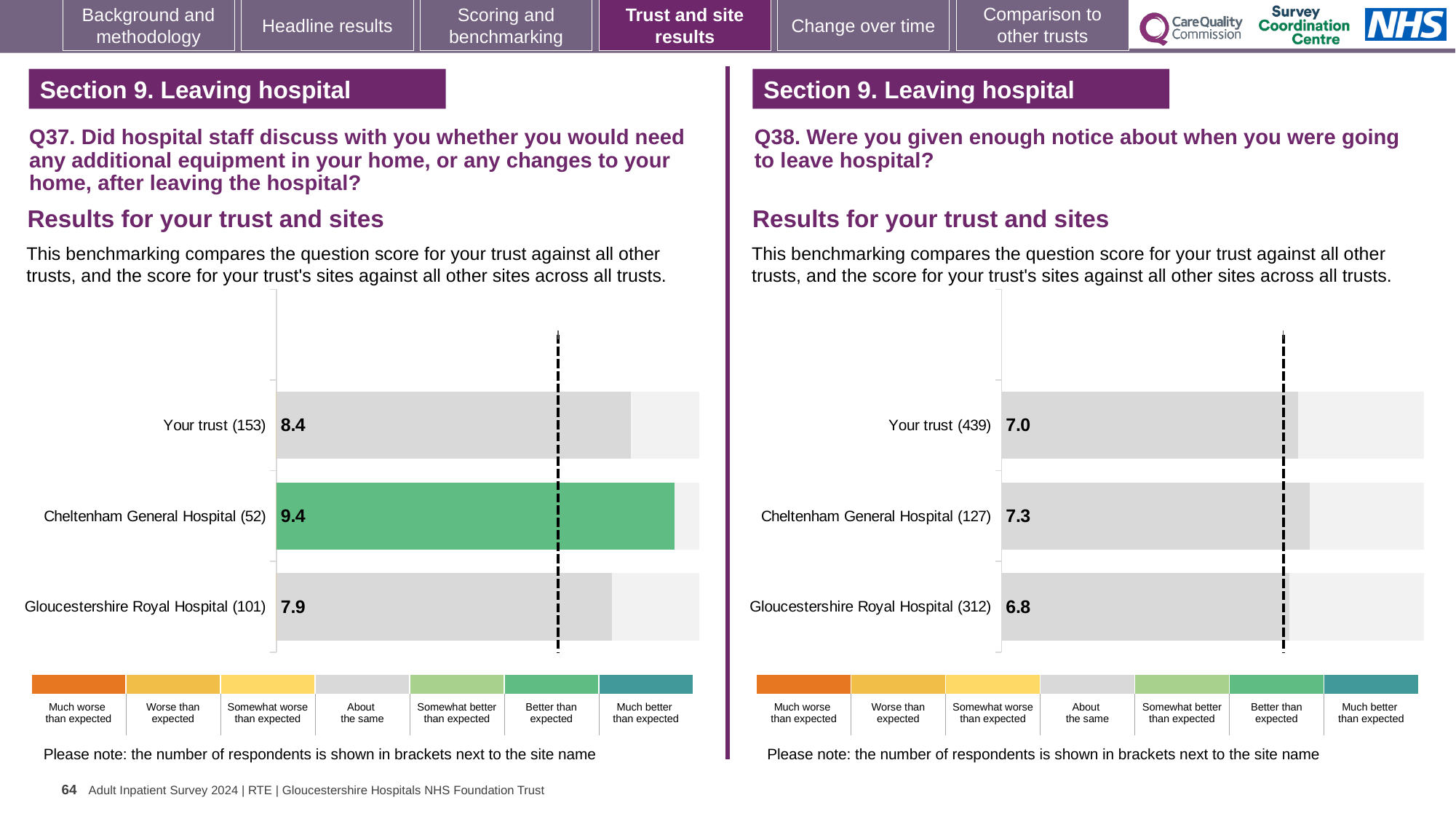
In the Q37 chart, which site or trust has the highest score? Cheltenham General Hospital In the Q37 chart, what is the score for Your trust? 8.4 In the Q37 chart, how many bars are plotted? 3 In the Q37 chart, which site or trust has the lowest score? Gloucestershire Royal Hospital In the Q38 chart, what is the score for Gloucestershire Royal Hospital? 6.8 In the Q38 chart, what is the score for Your trust? 7.0 In the Q38 chart, which site or trust has the highest score? Cheltenham General Hospital What kind of chart is used for the Q38 results? Bar chart In the Q37 chart, which bar is coloured green rather than grey? Cheltenham General Hospital In the Q37 chart, what is the score for Cheltenham General Hospital? 9.4 In the Q37 chart, what is the difference between the scores for Cheltenham General Hospital and Gloucestershire Royal Hospital? 1.5 In the Q38 chart, what is the difference between the scores for Cheltenham General Hospital and Your trust? 0.3